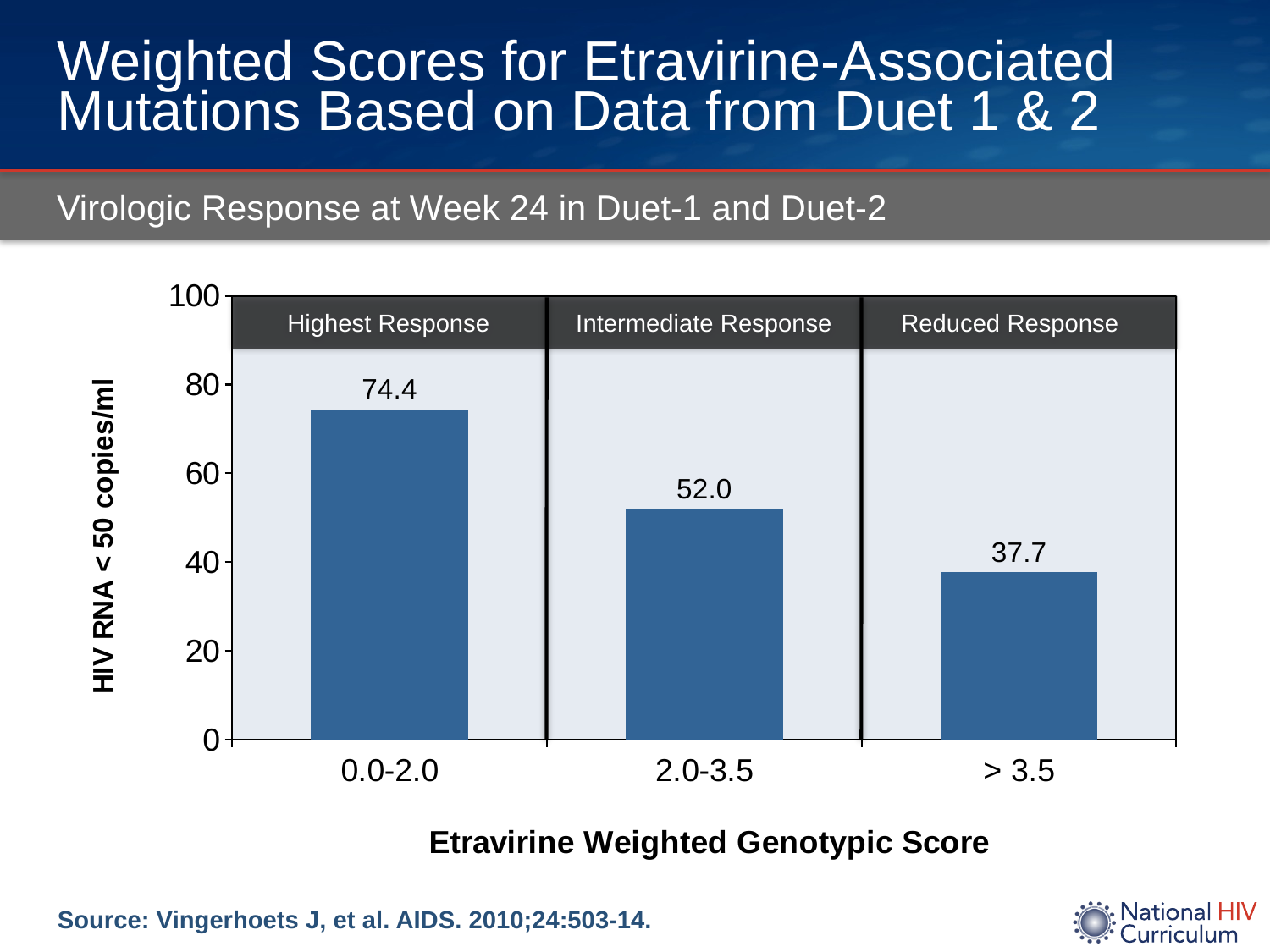
Is the value for the 2.0-3.5 category greater or less than 60? less What is the value for the 2.0-3.5 etravirine weighted genotypic score category? 52.0 What is the difference between the values for the 0.0-2.0 and > 3.5 categories? 36.7 What is the value for the > 3.5 etravirine weighted genotypic score category? 37.7 What is the difference between the values for the 0.0-2.0 and 2.0-3.5 categories? 22.4 Which etravirine weighted genotypic score category has the highest value? 0.0-2.0 What kind of chart is shown on the slide? Bar chart Which etravirine weighted genotypic score category has the lowest value? > 3.5 What is the value for the 0.0-2.0 etravirine weighted genotypic score category? 74.4 Which is larger, the value for 2.0-3.5 or the value for > 3.5? 2.0-3.5 Do the values rise or fall as the etravirine weighted genotypic score increases along the x axis? Fall How many categories are shown on the x axis of the chart? 3